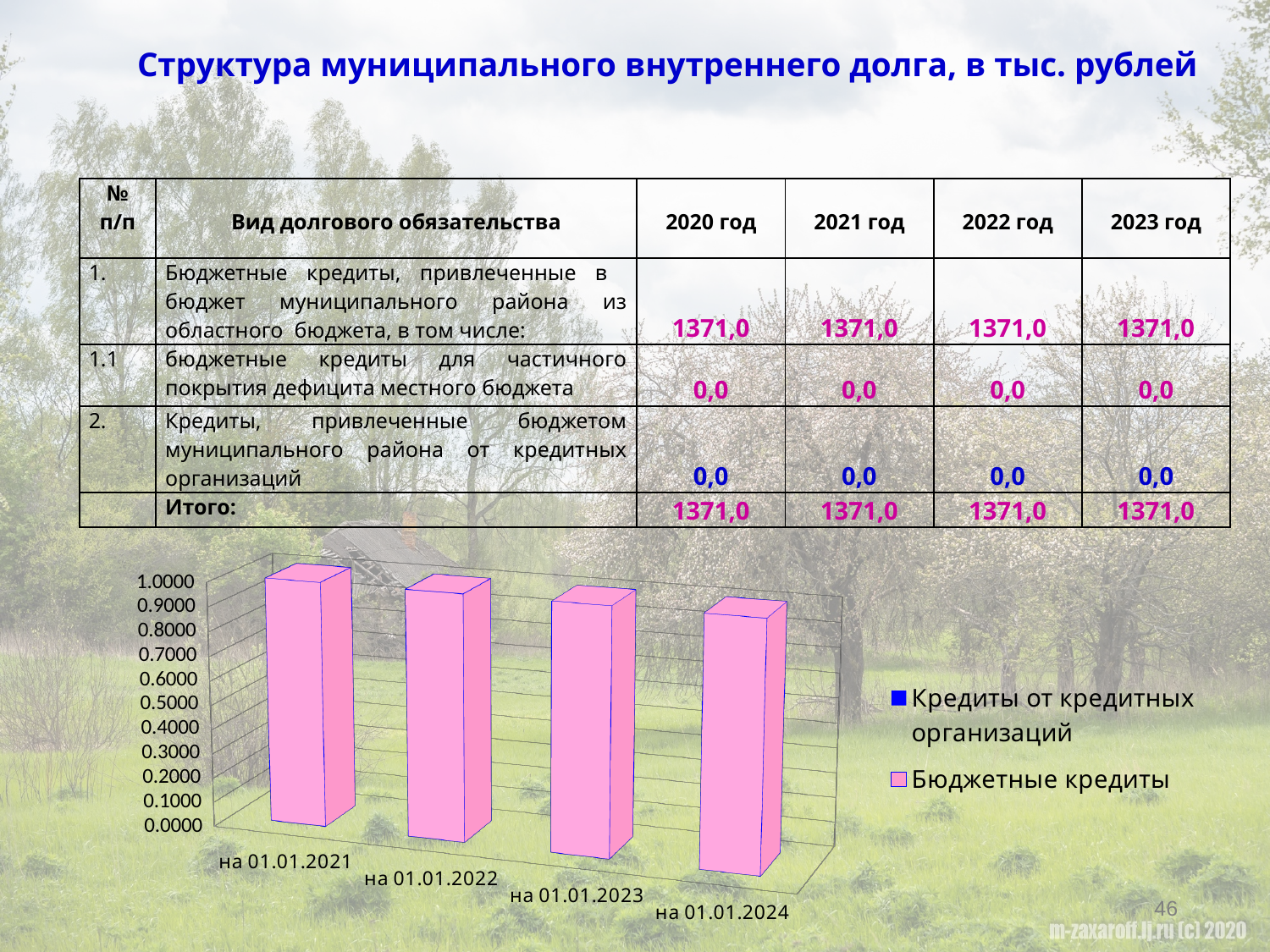
What kind of chart is shown on the slide? bar chart How many categories (dates) are shown along the x axis of the chart? 4 Is the value for на 01.01.2023 greater or less than 0.3000? greater Which series in the legend is shown in pink? Бюджетные кредиты Is the value for на 01.01.2024 greater or less than 0.5000? greater Is the value for на 01.01.2022 greater or less than 0.2000? greater What is the highest tick value shown on the vertical axis of the chart? 1.0000 What is the first category label on the x axis of the chart? на 01.01.2021 How many series does the chart legend list? 2